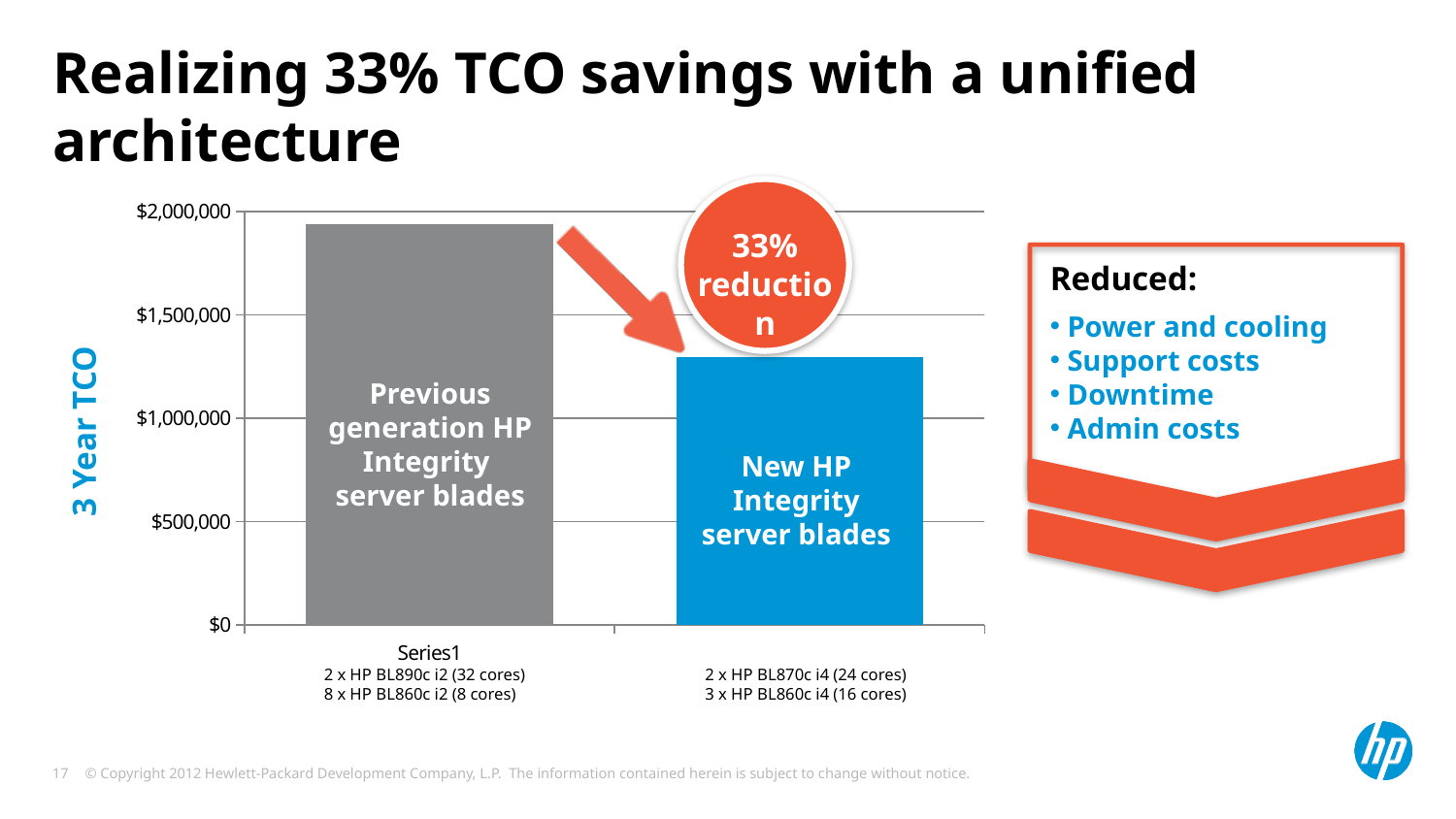
Is the 3 Year TCO for the new HP Integrity server blades greater or less than $1,000,000? greater What is the title of the vertical axis of the chart? 3 Year TCO Which is larger: the 3 Year TCO of the previous generation HP Integrity server blades or of the new HP Integrity server blades? Previous generation HP Integrity server blades How many bars are plotted in the chart? 2 Is the 3 Year TCO for the previous generation HP Integrity server blades greater or less than $2,000,000? less Is the 3 Year TCO for the previous generation HP Integrity server blades greater or less than $1,500,000? greater What kind of chart is shown on the slide? bar chart Which bar has the higher 3 Year TCO? Previous generation HP Integrity server blades Which bar has the lower 3 Year TCO? New HP Integrity server blades Do the bar values rise or fall from left to right across the chart? fall What percentage reduction does the circle annotation on the chart state? 33% reduction